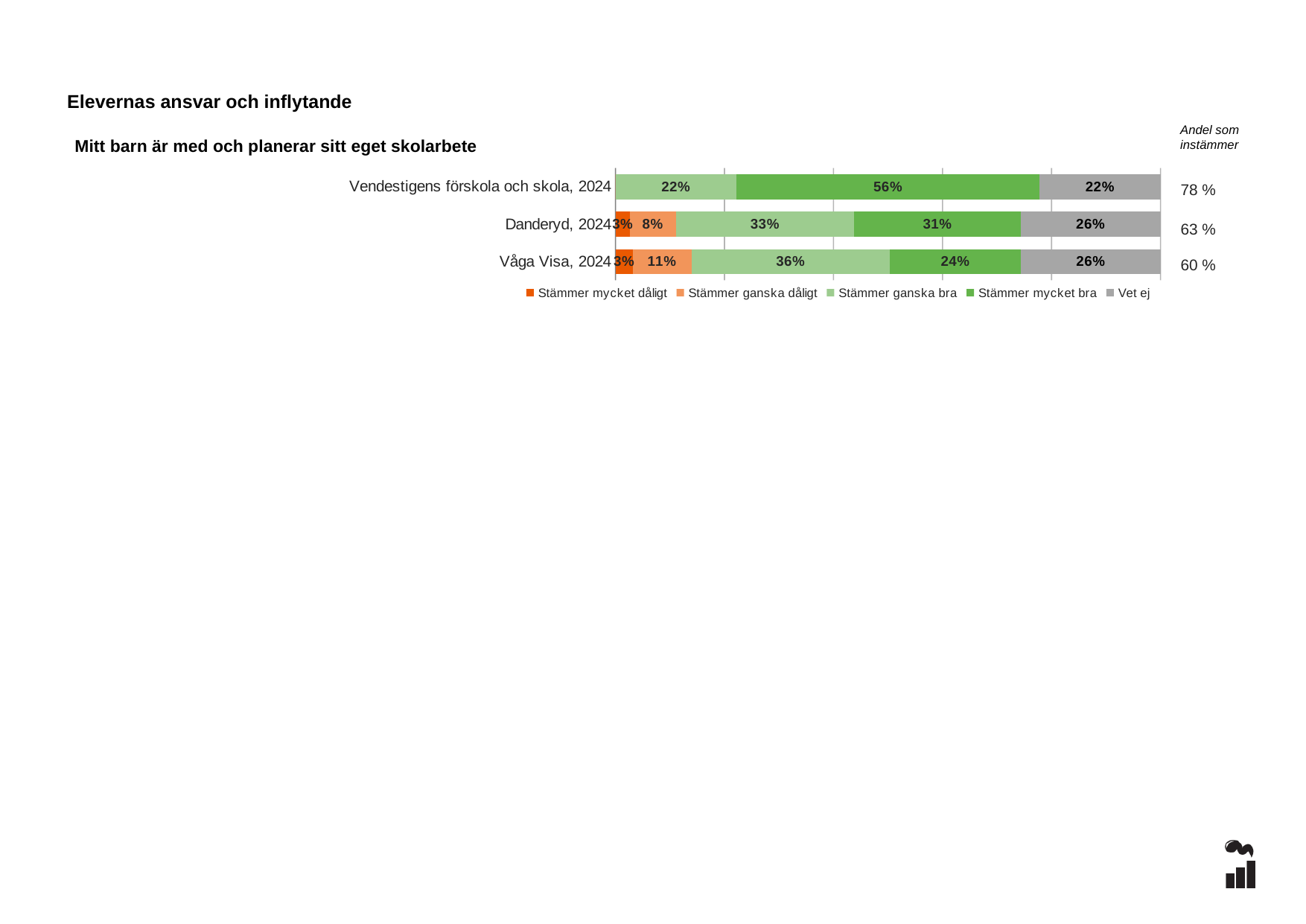
What is the value of "Stämmer ganska bra" for Våga Visa, 2024? 36% How many series does the legend list? 5 What is the "Andel som instämmer" value shown for Vendestigens förskola och skola, 2024? 78 % What is the value of "Vet ej" for Danderyd, 2024? 26% Which category has the lowest value for "Stämmer mycket bra"? Våga Visa, 2024 How many categories (bars) does the chart show? 3 What is the value of "Stämmer mycket bra" for Vendestigens förskola och skola, 2024? 56% What is the value of "Stämmer ganska dåligt" for Våga Visa, 2024? 11% What kind of chart is shown on the slide? Stacked bar chart Which category has the highest value for "Stämmer mycket bra"? Vendestigens förskola och skola, 2024 What is the difference between the "Stämmer mycket bra" values for Vendestigens förskola och skola, 2024 and Danderyd, 2024? 25 percentage points Which is larger: "Stämmer ganska bra" for Danderyd, 2024 or for Våga Visa, 2024? Våga Visa, 2024